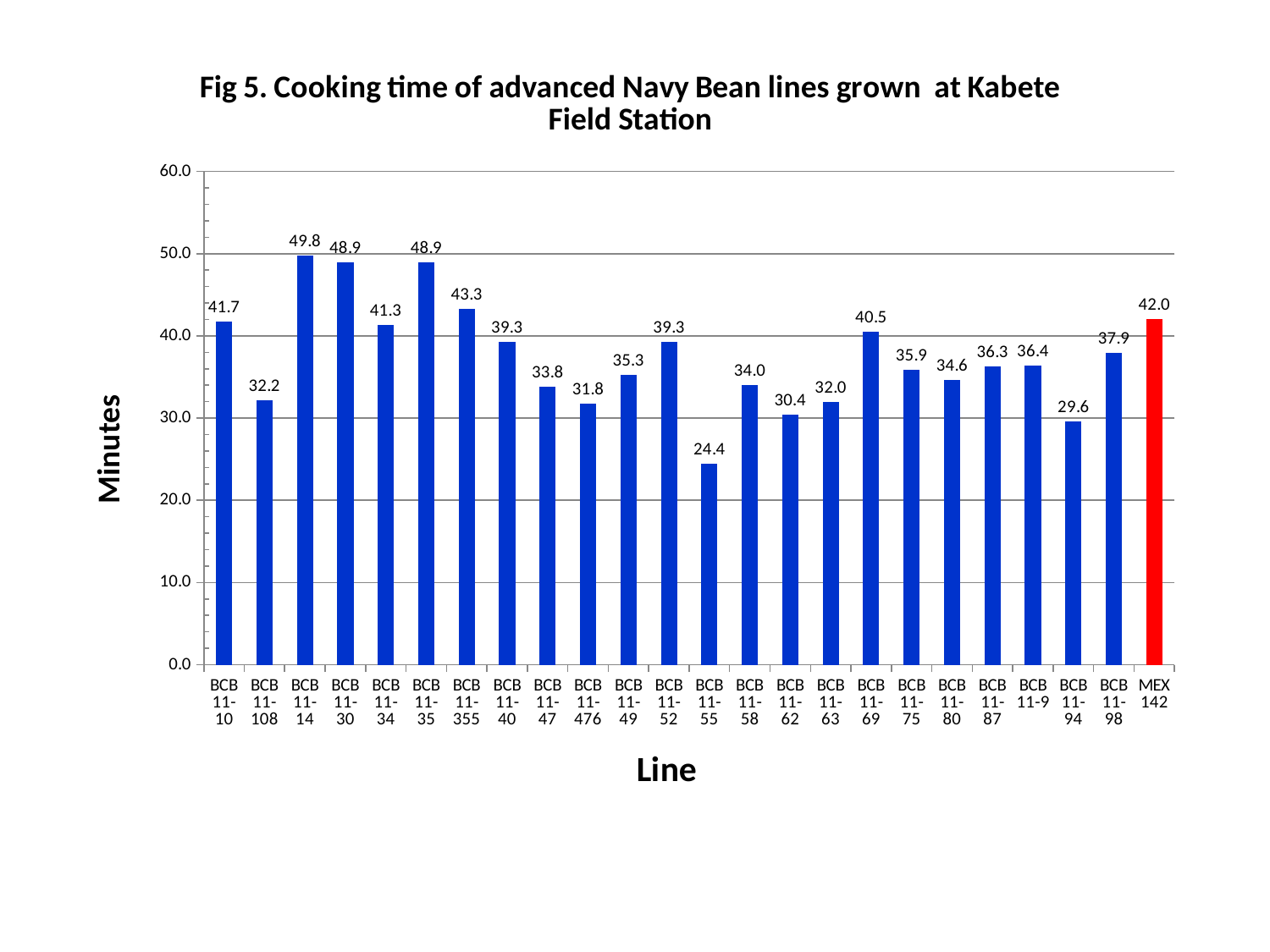
What is the difference in cooking time between BCB 11-355 and BCB 11-40? 4.0 What is the cooking time for BCB 11-476? 31.8 Is the cooking time for BCB 11-55 greater or less than 30.0? less How many lines are shown on the chart? 24 What is the cooking time for BCB 11-14? 49.8 What is the difference in cooking time between BCB 11-14 and BCB 11-55? 25.4 What is the cooking time for MEX 142? 42.0 Which has a longer cooking time, BCB 11-69 or BCB 11-98? BCB 11-69 Which line has the longest cooking time? BCB 11-14 Which bar is coloured red rather than blue? MEX 142 What kind of chart is shown on the slide? bar chart Which line has the shortest cooking time? BCB 11-55